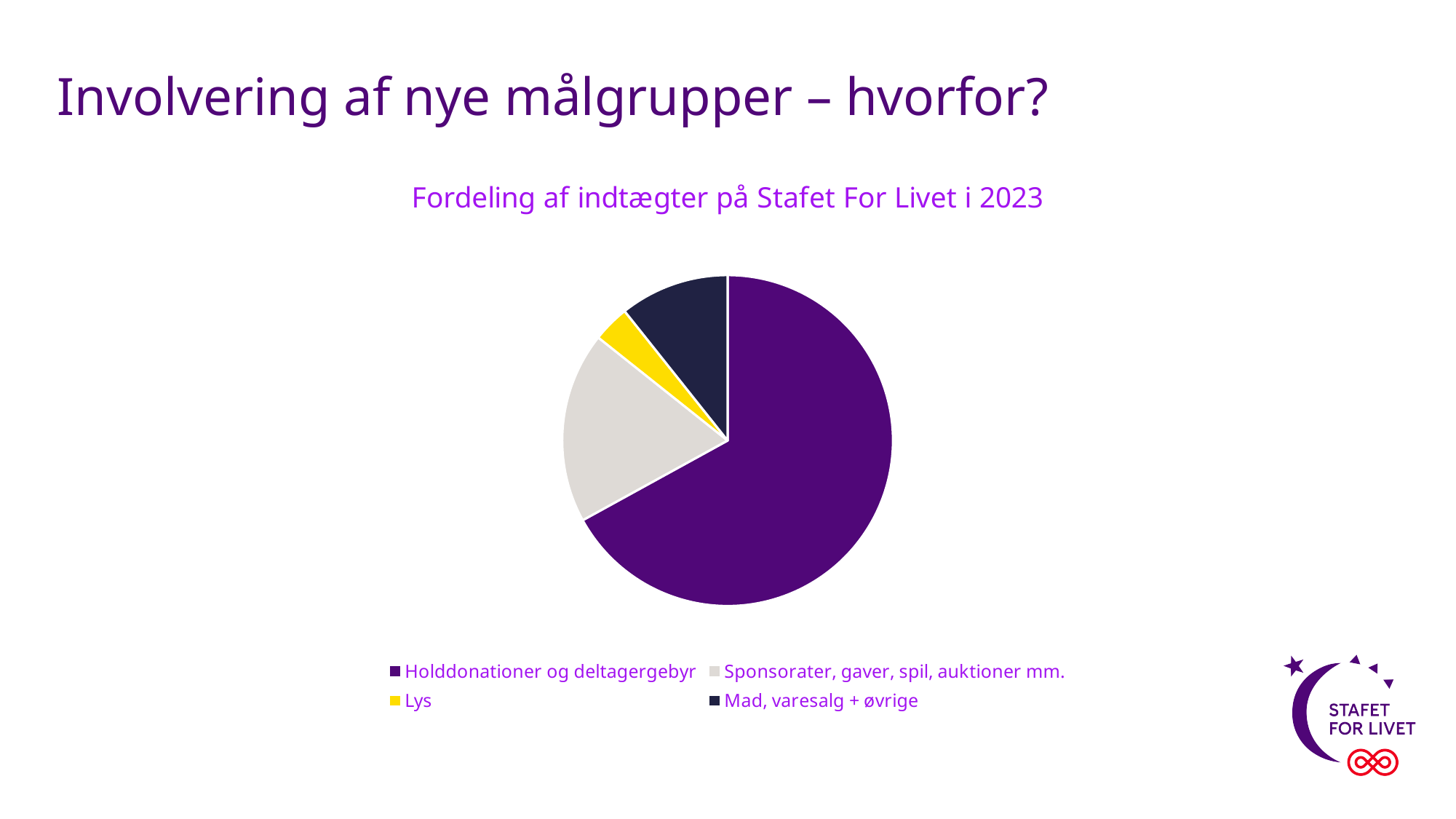
What kind of chart is shown on the slide? pie chart Which slice is larger: Sponsorater, gaver, spil, auktioner mm. or Mad, varesalg + øvrige? Sponsorater, gaver, spil, auktioner mm. What is the title of the chart? Fordeling af indtægter på Stafet For Livet i 2023 Which category is shown in yellow in the pie chart? Lys Does the Holddonationer og deltagergebyr slice make up more or less than half of the pie? more Which category has the smallest slice of the pie? Lys How many entries does the legend list? 4 Which slice is larger: Holddonationer og deltagergebyr or Sponsorater, gaver, spil, auktioner mm.? Holddonationer og deltagergebyr How many slices does the pie chart have? 4 Which category has the largest slice of the pie? Holddonationer og deltagergebyr